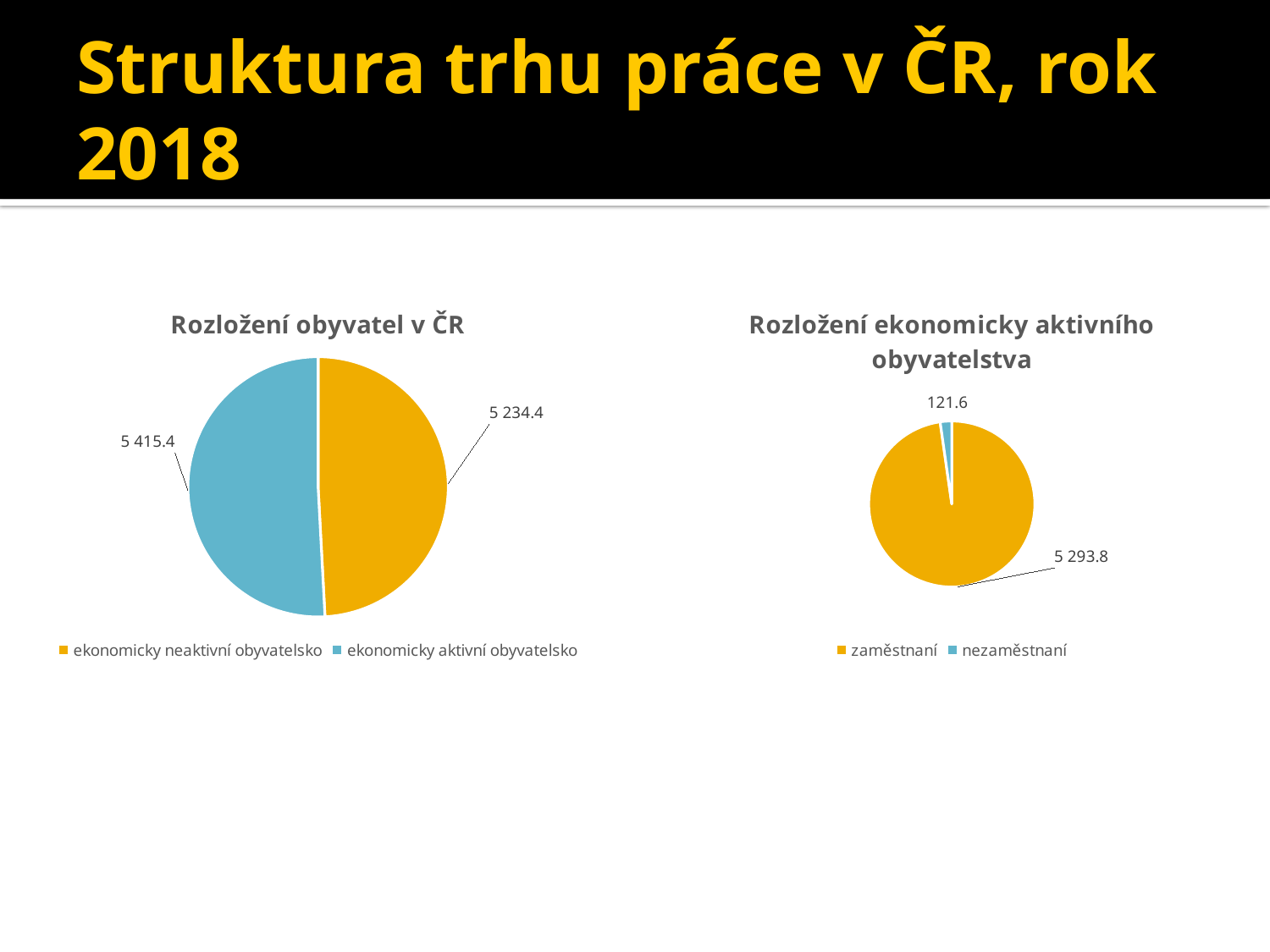
In the chart titled "Rozložení obyvatel v ČR", what is the value for ekonomicky neaktivní obyvatelsko? 5 234.4 In the chart titled "Rozložení obyvatel v ČR", what is the value for ekonomicky aktivní obyvatelsko? 5 415.4 What is the title of the chart on the right of the slide? Rozložení ekonomicky aktivního obyvatelstva In the chart titled "Rozložení ekonomicky aktivního obyvatelstva", what is the difference between zaměstnaní and nezaměstnaní? 5 172.2 In the chart titled "Rozložení ekonomicky aktivního obyvatelstva", which category has the smallest value? nezaměstnaní In the chart titled "Rozložení obyvatel v ČR", what is the difference between ekonomicky aktivní obyvatelsko and ekonomicky neaktivní obyvatelsko? 181.0 What kind of chart is the chart on the left of the slide? pie chart In the chart titled "Rozložení ekonomicky aktivního obyvatelstva", what is the value for zaměstnaní? 5 293.8 In the chart titled "Rozložení obyvatel v ČR", which category has the larger value? ekonomicky aktivní obyvatelsko In the chart titled "Rozložení ekonomicky aktivního obyvatelstva", what is the value for nezaměstnaní? 121.6 In the chart titled "Rozložení ekonomicky aktivního obyvatelstva", is the value for zaměstnaní larger or smaller than the value for nezaměstnaní? larger How many categories does the chart titled "Rozložení ekonomicky aktivního obyvatelstva" show? 2